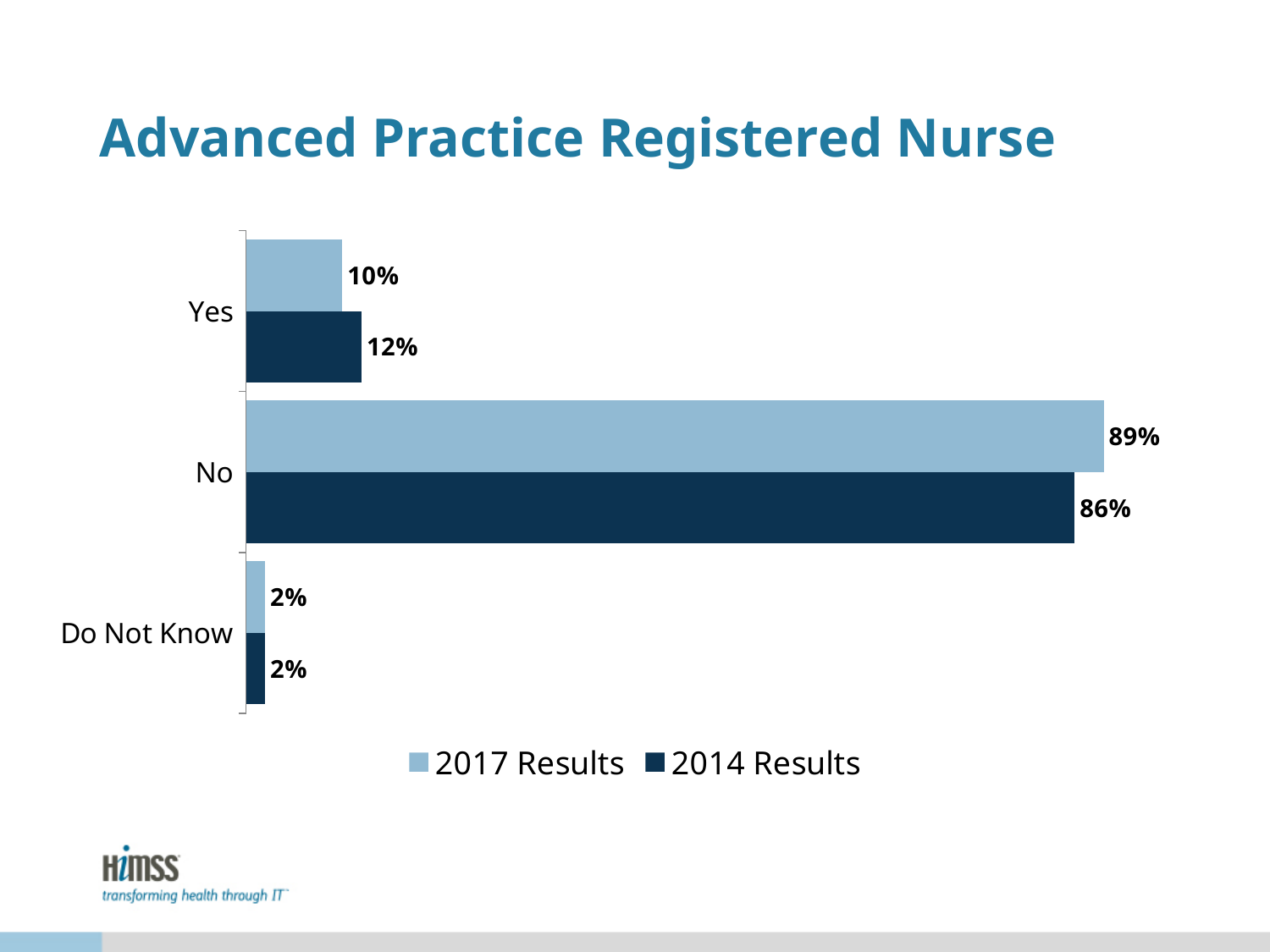
What kind of chart is shown on the slide? Bar chart What is the 2017 Results value for Yes? 10% What is the 2014 Results value for Yes? 12% What is the 2017 Results value for Do Not Know? 2% Which category has the highest 2017 Results value? No What is the difference between the 2017 Results and 2014 Results values for No? 3% What is the 2014 Results value for No? 86% How many series does the legend list? 2 How many categories are shown on the chart? 3 What is the title of the slide? Advanced Practice Registered Nurse Which category has the lowest 2014 Results value? Do Not Know Which is larger for Yes: the 2017 Results value or the 2014 Results value? 2014 Results